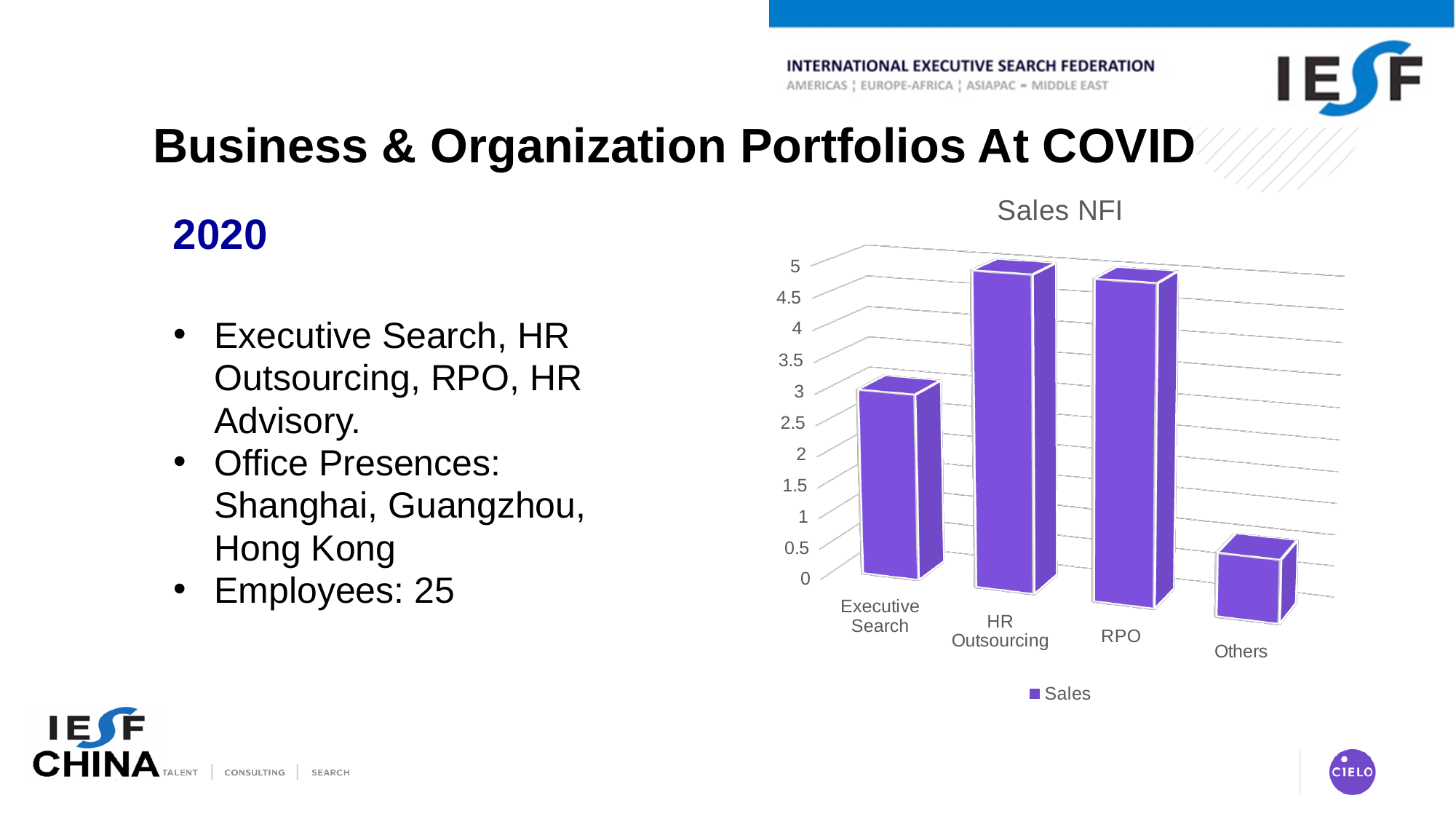
Is the Sales value for RPO greater or less than 4? greater Which has the larger Sales value, Executive Search or Others? Executive Search How many categories are shown on the x axis of the chart? 4 What kind of chart is shown on the slide? bar chart What series name appears in the chart's legend? Sales Is the Sales value for HR Outsourcing greater or less than 4? greater How many series does the chart's legend list? 1 Is the Sales value for Others greater or less than 2? less Which category has the lowest Sales value? Others What is the title of the chart? Sales NFI